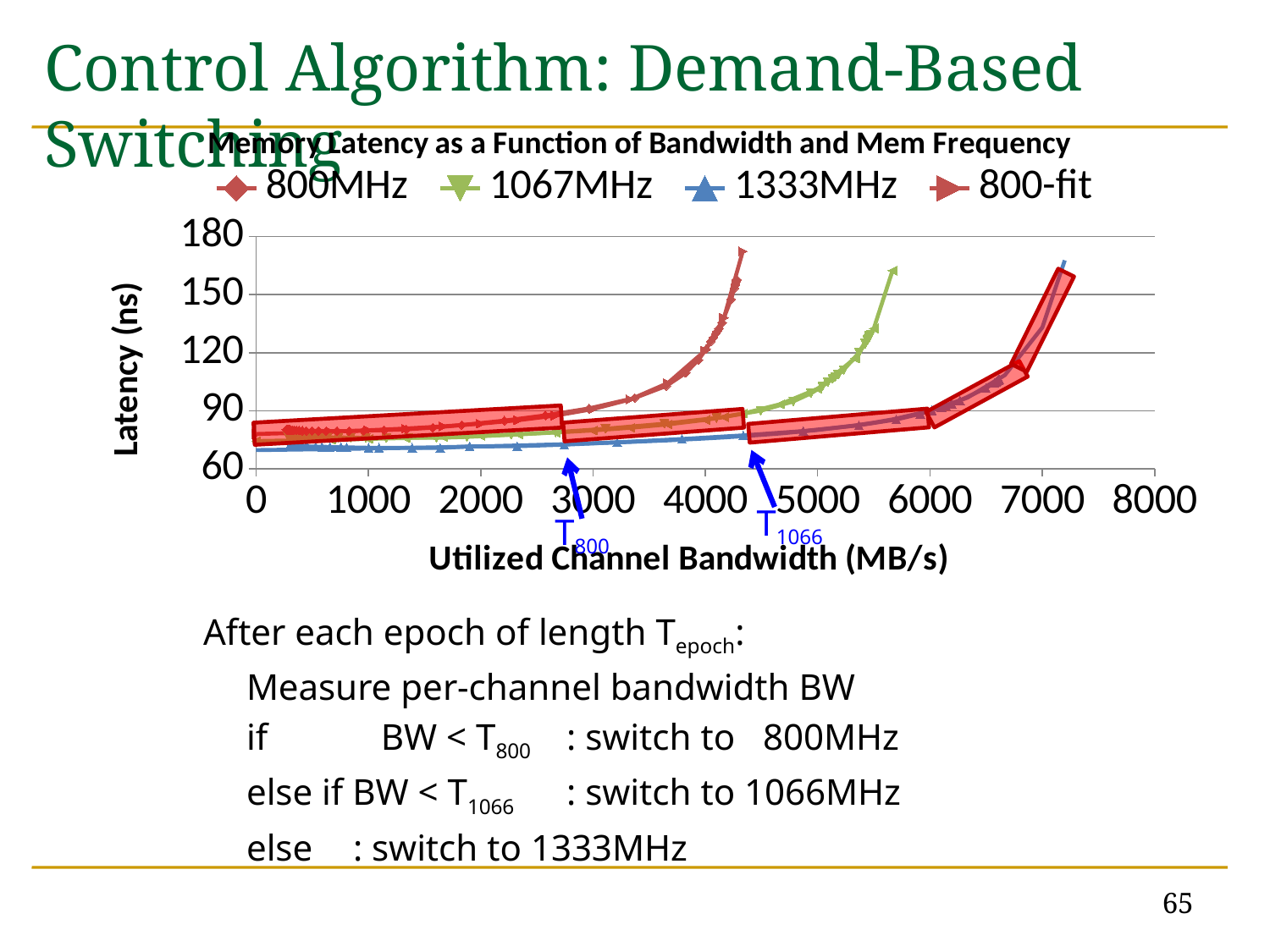
Is the latency of the 1333MHz series at 0 MB/s greater or less than 90? less Does latency rise or fall as utilized channel bandwidth increases along the x axis? rise Is the latency of the 1333MHz series at 7000 MB/s greater or less than 90? greater What is the title of the chart? Memory Latency as a Function of Bandwidth and Mem Frequency Is the latency of the 1067MHz series at 5000 MB/s greater or less than 90? greater What kind of chart is shown on the slide? line chart What is the label of the chart's y axis? Latency (ns) How many series does the chart legend list? 4 Which series' latency rises steeply at the lowest bandwidth? 800MHz Which series has the lowest latency at low bandwidth (near 0 MB/s)? 1333MHz